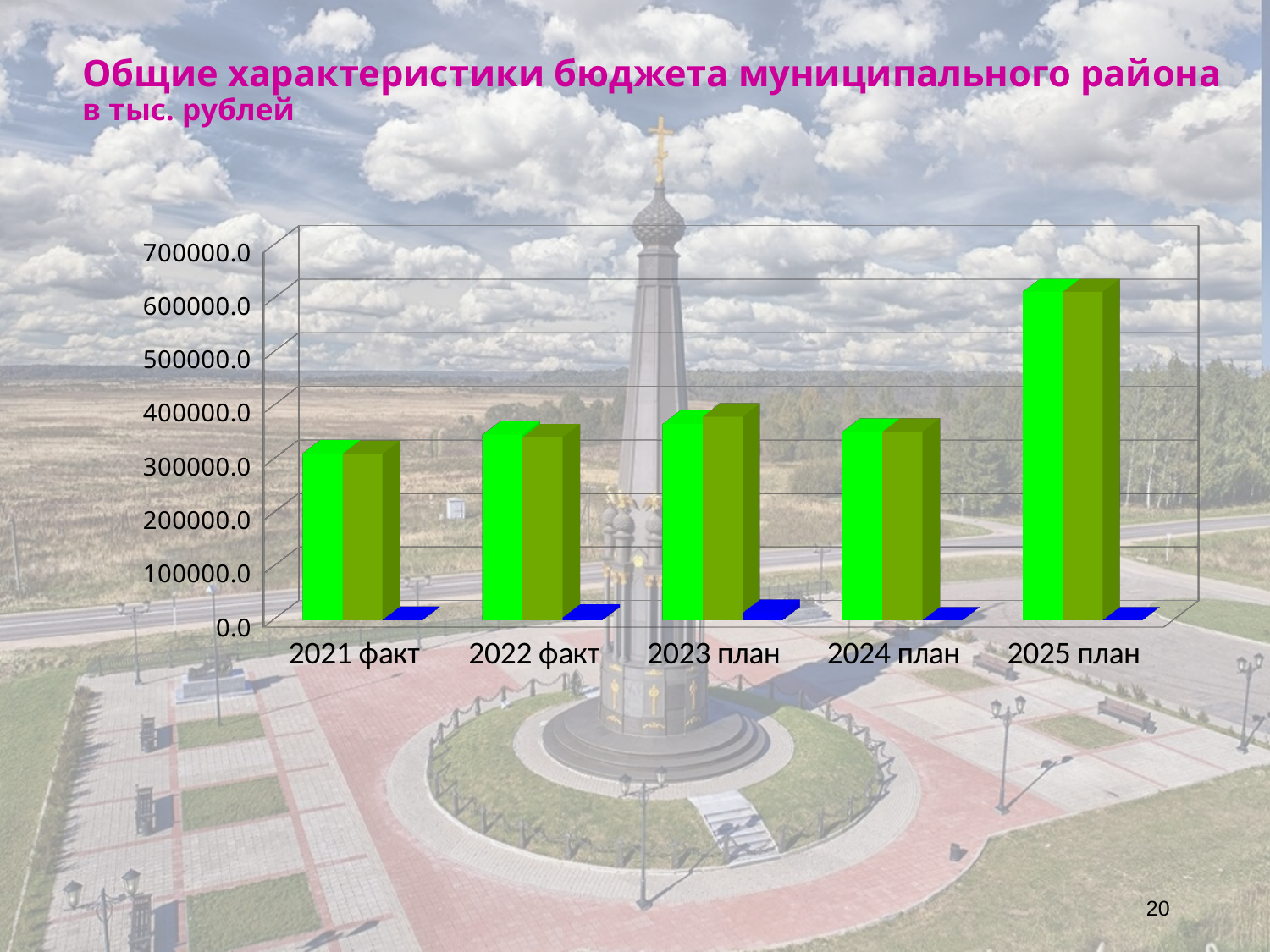
Is the green bar for 2021 факт greater or less than 400000.0? less How many categories are shown on the x axis of the chart? 5 What kind of chart is shown on the slide? bar chart In what units are the values on the chart expressed, according to the subtitle? в тыс. рублей Is the green bar for 2025 план greater or less than 500000.0? greater Is the green bar for 2023 план greater or less than 300000.0? greater What is the title of the chart on the slide? Общие характеристики бюджета муниципального района Which green bar is taller: 2025 план or 2024 план? 2025 план Which category has the highest green bar? 2025 план Which green bar is taller: 2023 план or 2021 факт? 2023 план Which category has the lowest green bar? 2021 факт